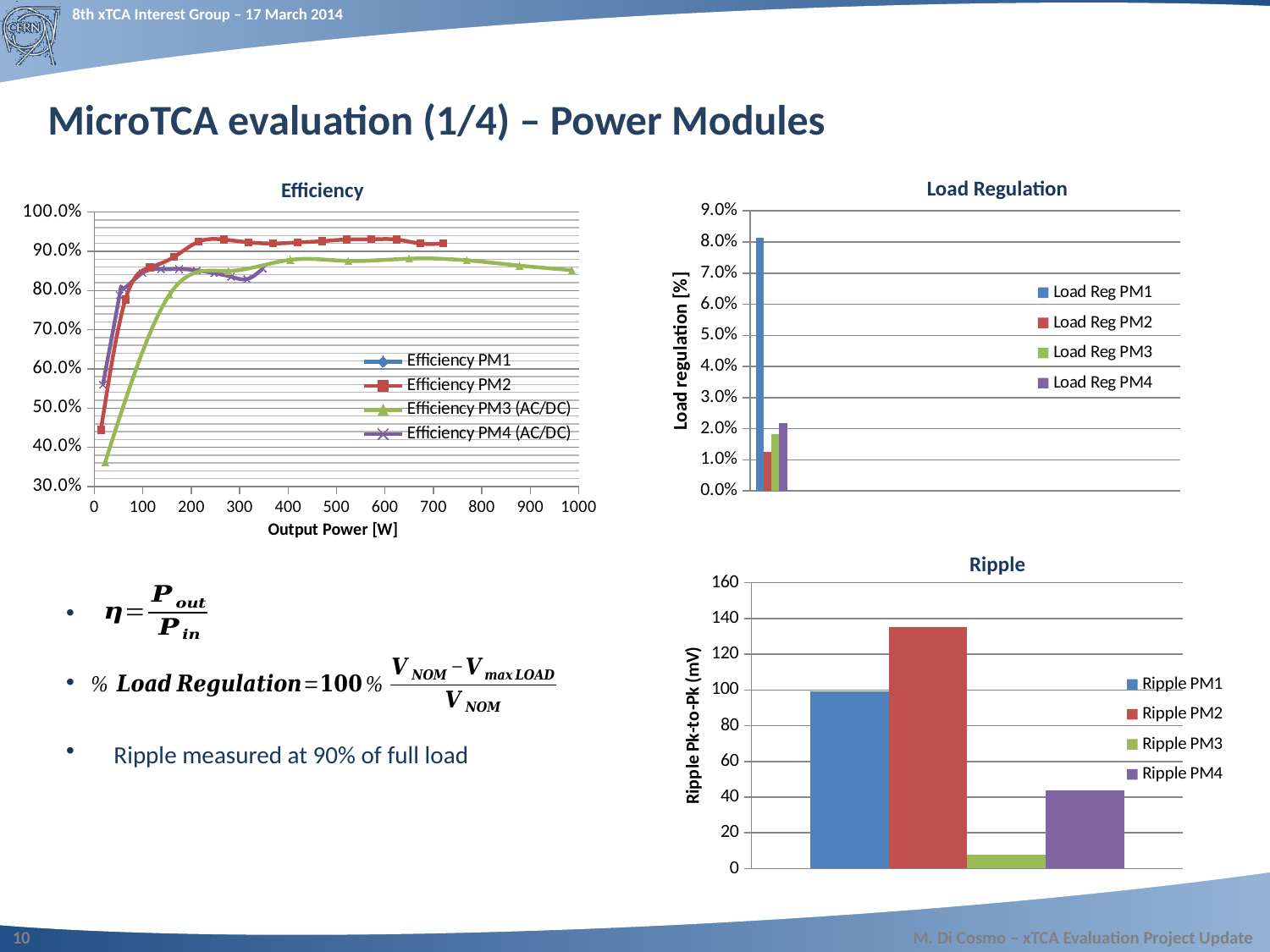
In the Efficiency chart, which series has the lowest efficiency at the lowest output power? Efficiency PM3 (AC/DC) In the Ripple chart, which power module has the lowest ripple? Ripple PM3 In the Load Regulation chart, which power module has the lowest load regulation? Load Reg PM2 What is the x-axis title of the Efficiency chart? Output Power [W] In the Efficiency chart, does the efficiency of PM2 rise or fall between 0 W and 200 W output power? rise How many series does the legend of the Efficiency chart list? 4 In the Load Regulation chart, which power module has the highest load regulation? Load Reg PM1 In the Load Regulation chart, is the value for Load Reg PM1 greater or less than 7.0%? greater What kind of chart is the Efficiency chart? line chart In the Ripple chart, is the value for Ripple PM4 greater or less than 60? less In the Ripple chart, which power module has the highest ripple? Ripple PM2